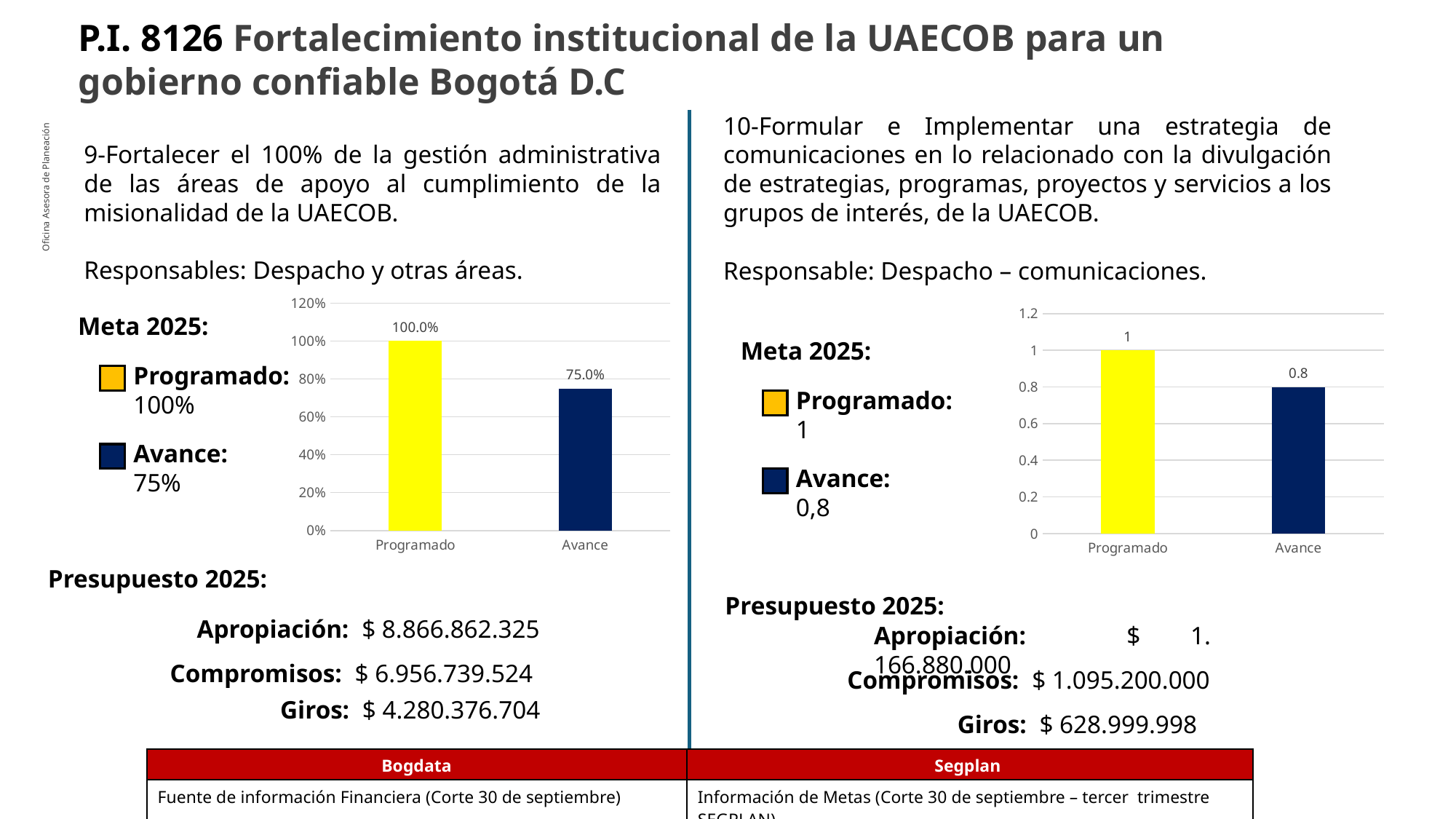
In the right chart, what is the highest value shown on the vertical axis? 1.2 In the left chart, what is the value for Programado? 100.0% In the left chart, what is the value for Avance? 75.0% In the left chart, how many bars are plotted? 2 In the right chart, which category has the higher value? Programado What type of chart is the left chart? Bar chart In the right chart, what is the value for Avance? 0.8 In the left chart, what is the difference between Programado and Avance? 25.0% In the left chart, which category has the lower value? Avance In the right chart, what is the difference between Programado and Avance? 0.2 In the left chart, what colour is the Programado bar? Yellow In the right chart, what is the value for Programado? 1